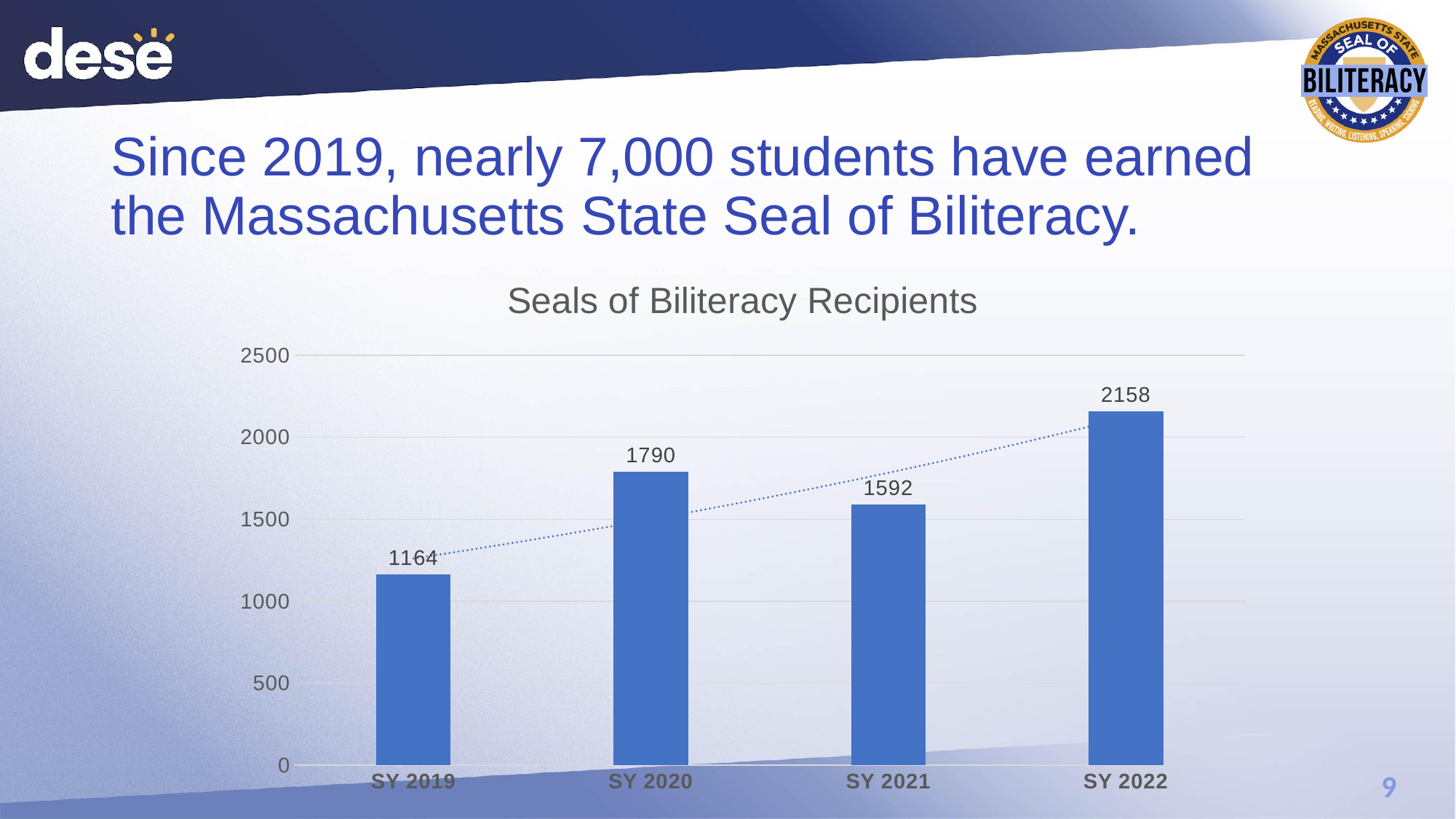
Which is larger, the value for SY 2020 or the value for SY 2021? SY 2020 Which school year has the highest number of Seals of Biliteracy recipients? SY 2022 What is the title of the chart? Seals of Biliteracy Recipients Which school year has the lowest number of Seals of Biliteracy recipients? SY 2019 What is the value for SY 2021? 1592 What is the value for SY 2022? 2158 How many school years are shown on the x axis? 4 What is the difference between the values for SY 2020 and SY 2021? 198 What is the value for SY 2019? 1164 What is the difference between the values for SY 2022 and SY 2019? 994 Is the value for SY 2022 greater or less than 2000? greater What kind of chart is shown on the slide? bar chart